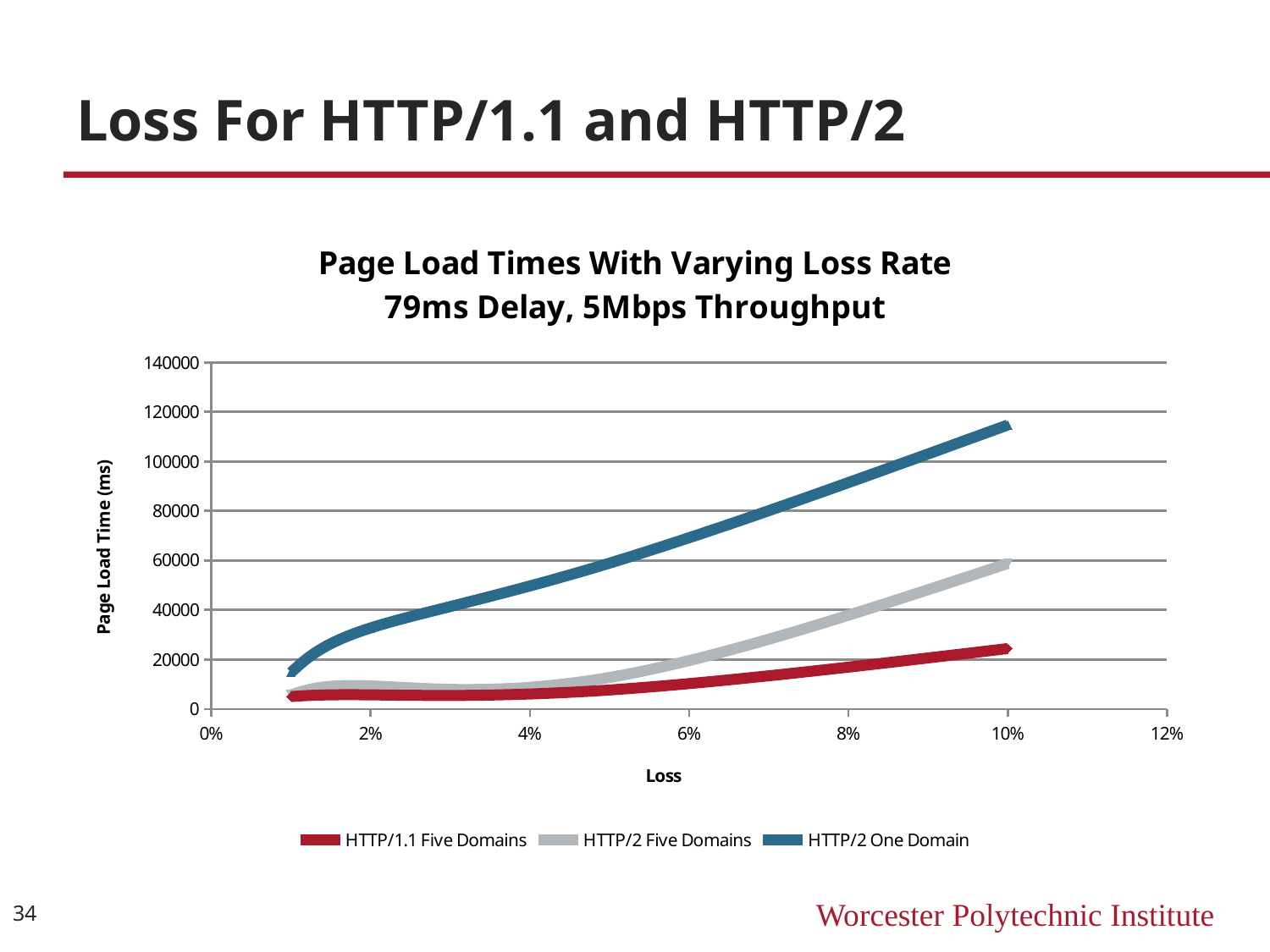
Is the page load time for HTTP/2 Five Domains at 10% loss greater or less than 40000? greater What kind of chart is shown on the slide? line chart At 8% loss, which is larger: the page load time for HTTP/2 Five Domains or for HTTP/1.1 Five Domains? HTTP/2 Five Domains Is the page load time for HTTP/1.1 Five Domains at 10% loss greater or less than 40000? less At 10% loss, which is larger: the page load time for HTTP/2 One Domain or for HTTP/1.1 Five Domains? HTTP/2 One Domain Do the page load times rise or fall as the loss rate increases? rise Which series has the highest page load time at 10% loss? HTTP/2 One Domain How many series does the legend list? 3 What is the label on the vertical axis of the chart? Page Load Time (ms) Is the page load time for HTTP/2 One Domain at 10% loss greater or less than 100000? greater Which series has the lowest page load time at 10% loss? HTTP/1.1 Five Domains